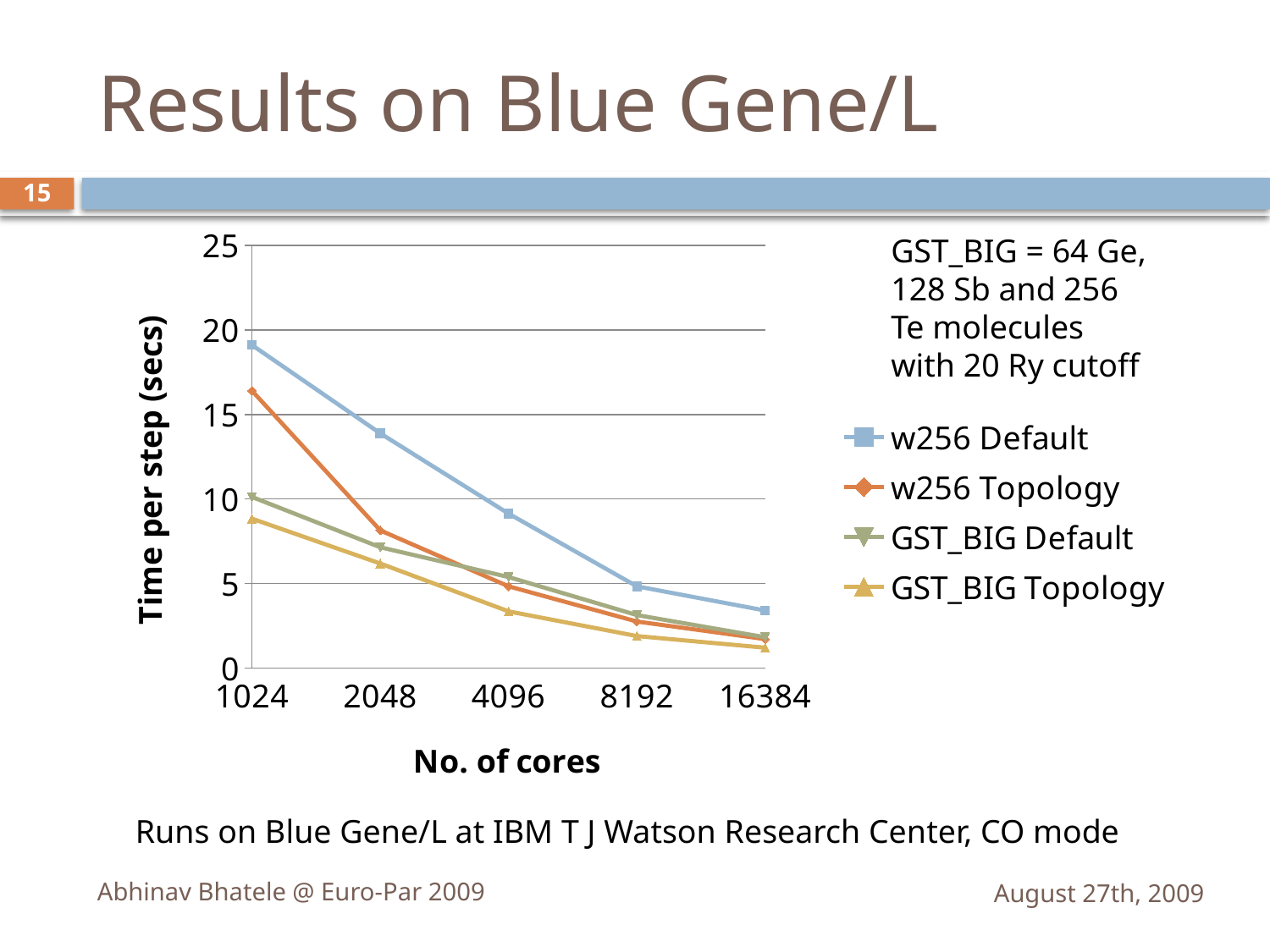
What is the label of the x axis? No. of cores Is the time per step for w256 Default at 1024 cores greater or less than 15? greater How many core counts are plotted along the x axis? 5 Which series has the highest time per step at 1024 cores? w256 Default Does the time per step for w256 Default rise or fall as the number of cores increases? fall Is the time per step for GST_BIG Topology at 4096 cores greater or less than 5? less Is the time per step for w256 Topology at 2048 cores greater or less than 10? less At 2048 cores, which is larger: the time per step for w256 Default or for w256 Topology? w256 Default How many series does the legend list? 4 What is the label of the y axis? Time per step (secs) What kind of chart is shown on the slide? line chart Which series has the lowest time per step at 1024 cores? GST_BIG Topology